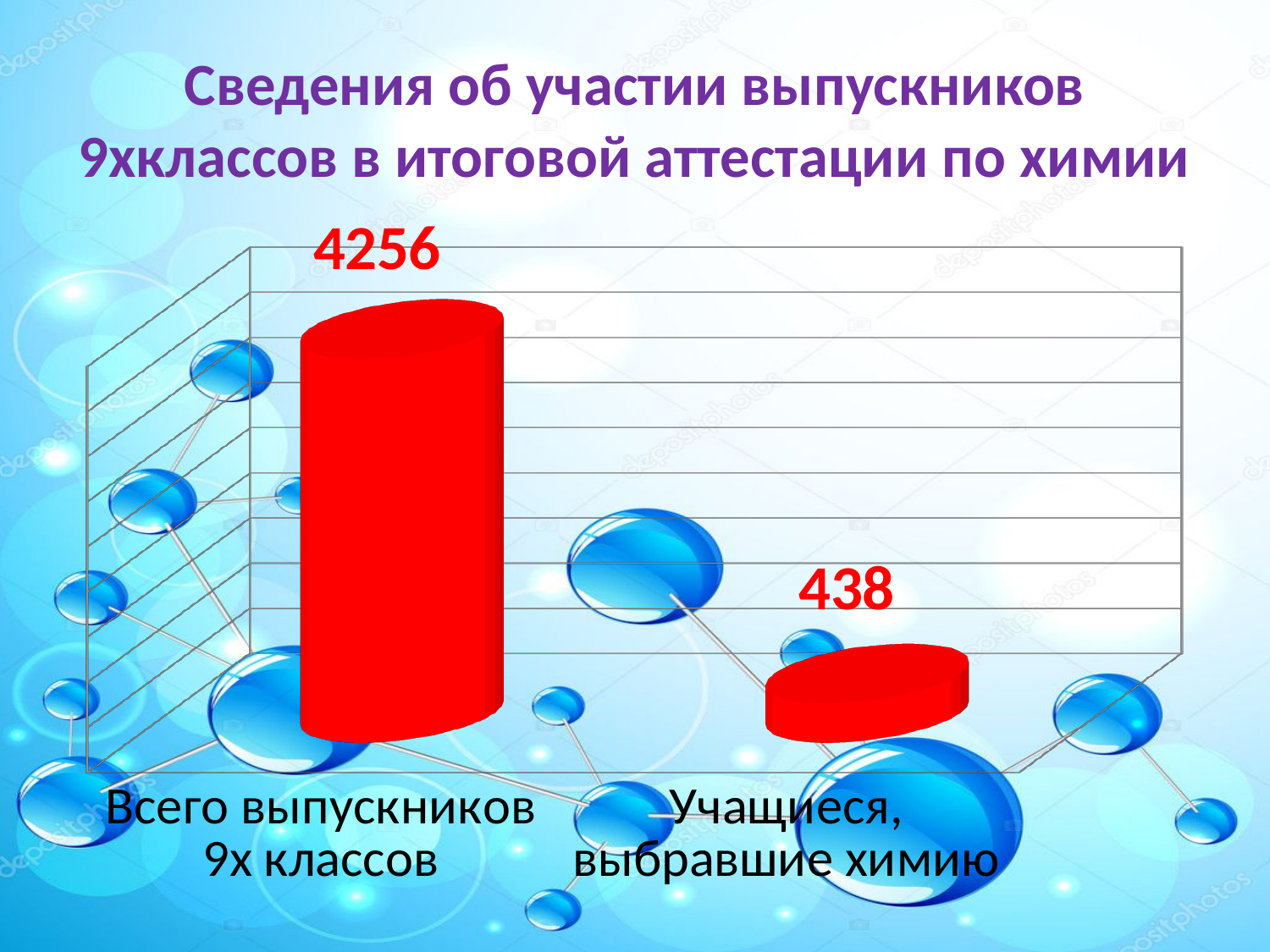
What is the difference between the value for Всего выпускников 9х классов and the value for Учащиеся, выбравшие химию? 3818 Which category has the lowest value? Учащиеся, выбравшие химию Which category has the highest value? Всего выпускников 9х классов What is the value for Учащиеся, выбравшие химию? 438 Which is larger: the value for Всего выпускников 9х классов or the value for Учащиеся, выбравшие химию? Всего выпускников 9х классов What kind of chart is shown on the slide? bar chart What is the value for Всего выпускников 9х классов? 4256 How many categories are shown in the chart? 2 What colour are the bars in the chart? red What is the title of the slide? Сведения об участии выпускников 9хклассов в итоговой аттестации по химии Do the values rise or fall from left to right across the categories? fall